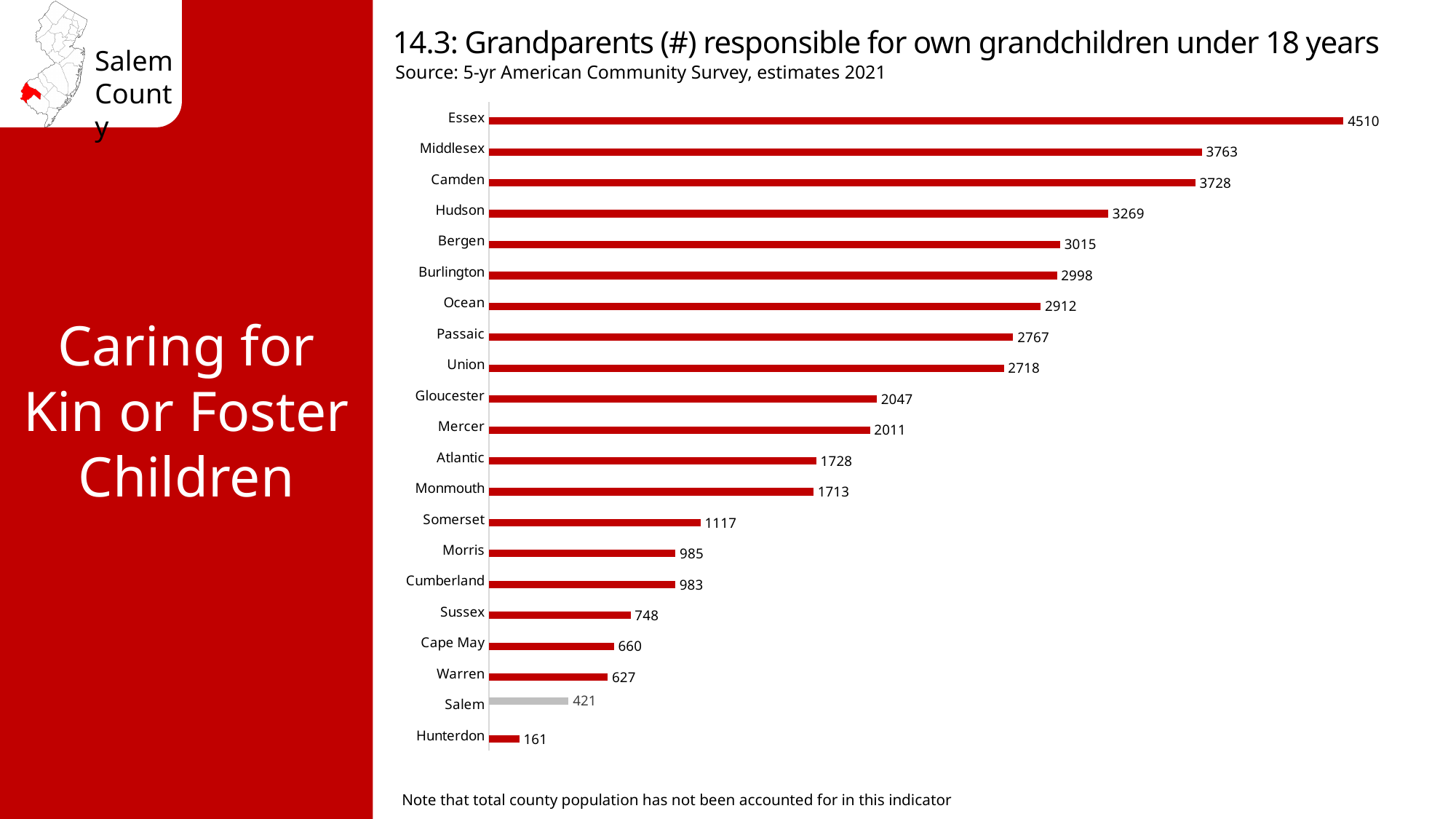
Which county has the lowest value? Hunterdon What is the value for Essex? 4510 Which is larger, the value for Salem or the value for Warren? Warren What is the difference between the values for Essex and Salem? 4089 What is the value for Gloucester? 2047 What kind of chart is shown on the slide? Bar chart What is the value for Salem? 421 Which county has the highest value? Essex Which is larger, the value for Hudson or the value for Bergen? Hudson How many counties are shown in the chart? 21 What is the difference between the values for Middlesex and Camden? 35 Which county's bar is shown in grey rather than red? Salem